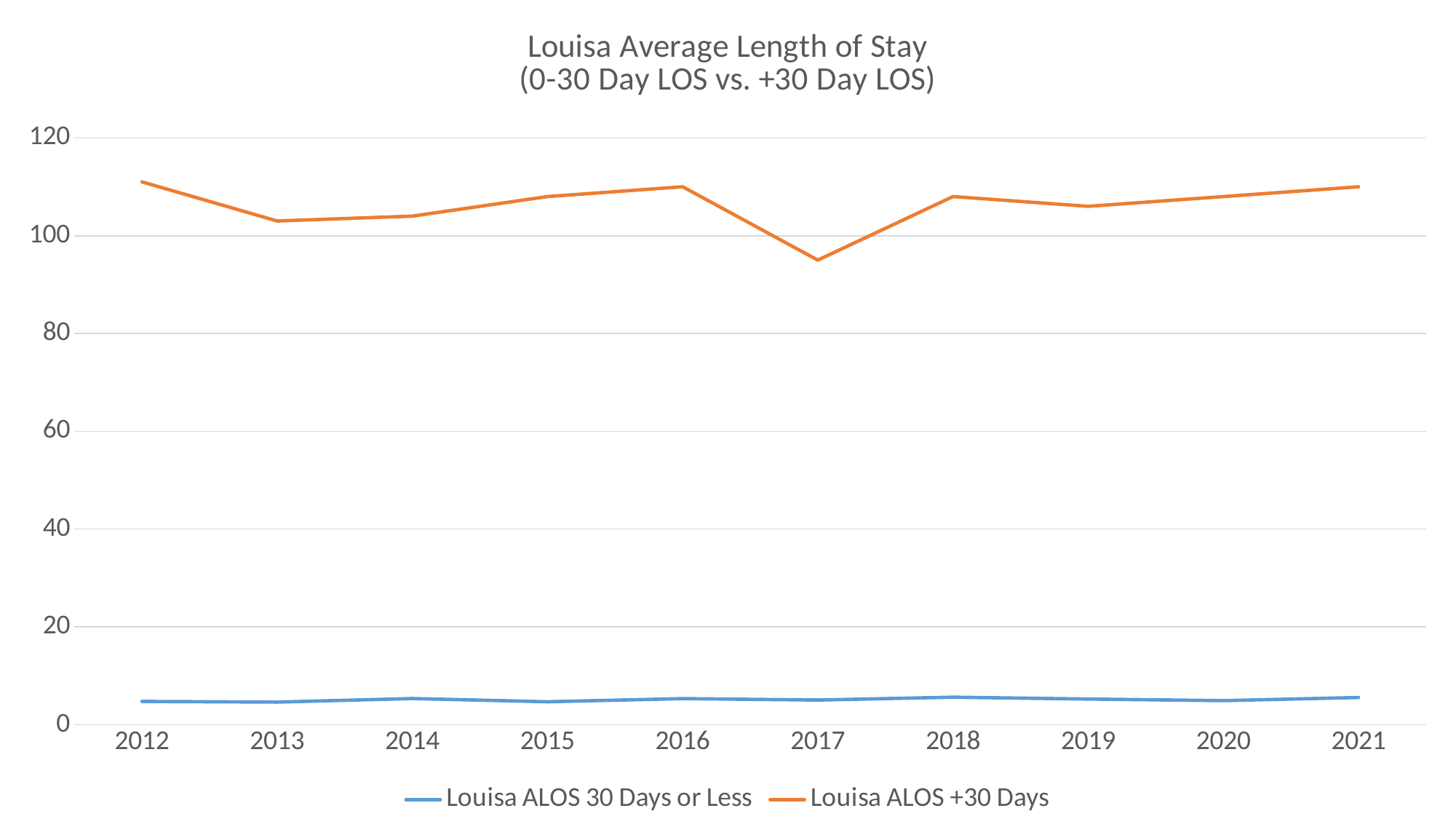
How many years are plotted along the x axis? 10 How many series does the legend list? 2 Which is larger for Louisa ALOS +30 Days, the value in 2016 or the value in 2017? 2016 In which year is the Louisa ALOS +30 Days value lowest? 2017 What is the title of the chart? Louisa Average Length of Stay (0-30 Day LOS vs. +30 Day LOS) Does the Louisa ALOS +30 Days line rise or fall from 2017 to 2018? rise Which series has the higher value in 2019, Louisa ALOS 30 Days or Less or Louisa ALOS +30 Days? Louisa ALOS +30 Days Is the Louisa ALOS 30 Days or Less value for 2016 greater or less than 20? less Is the Louisa ALOS +30 Days value for 2012 greater or less than 100? greater What type of chart is shown on the slide? line chart Is the Louisa ALOS +30 Days value for 2017 greater or less than 100? less What colour is the line for Louisa ALOS +30 Days? orange